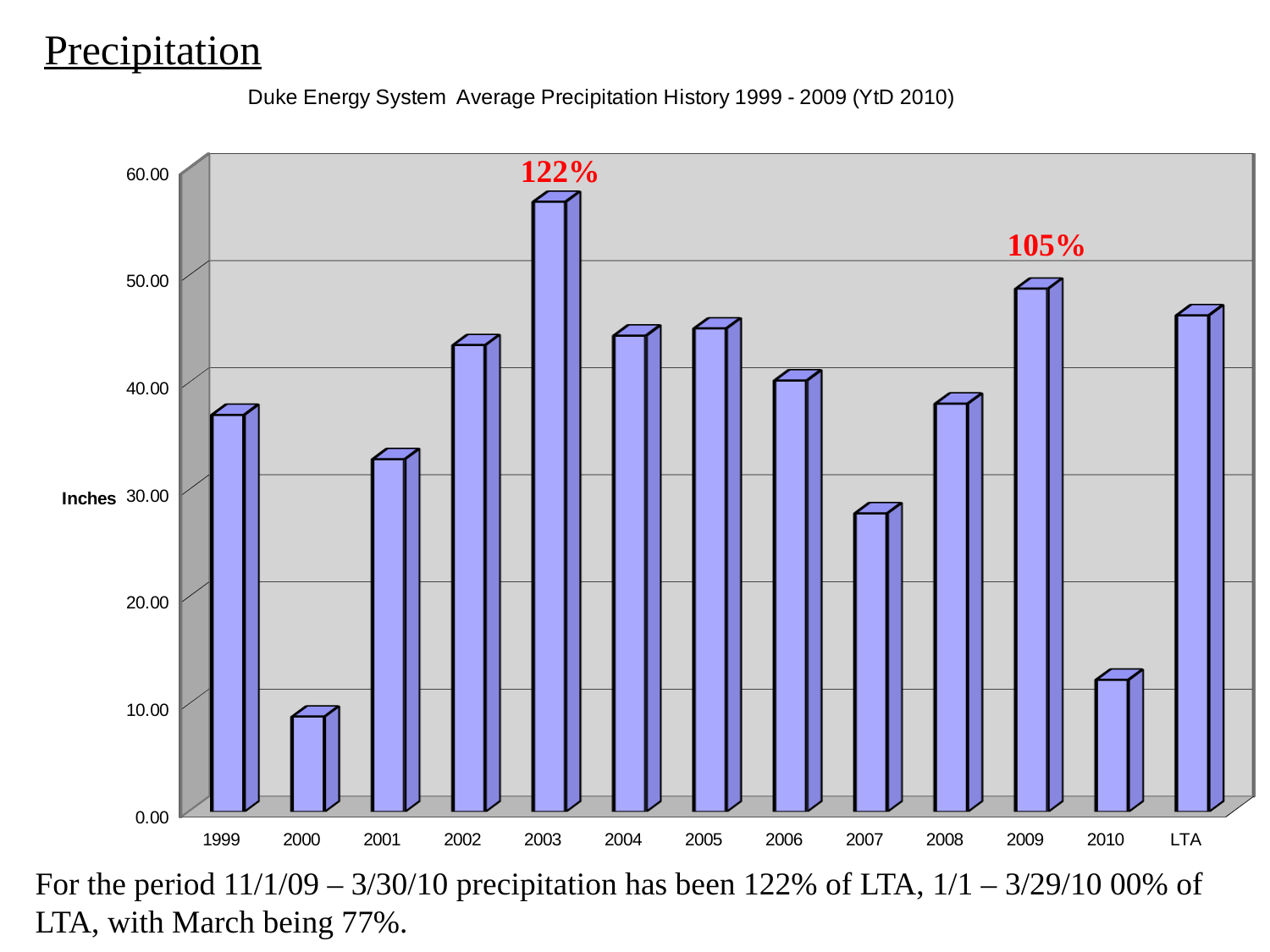
Is the value for 2000 greater or less than 10.00? less What kind of chart is shown on the slide? bar chart Which bar is taller, 2003 or 2009? 2003 Is the value for 2010 greater or less than 10.00? greater Which year has the highest precipitation bar? 2003 Is the value for 2007 greater or less than 30.00? less What percentage label is printed above the 2003 bar? 122% Which bar is taller, 2007 or 2008? 2008 Which year has the lowest precipitation bar? 2000 What is the label on the vertical axis of the chart? Inches How many bars (categories) are plotted on the chart? 13